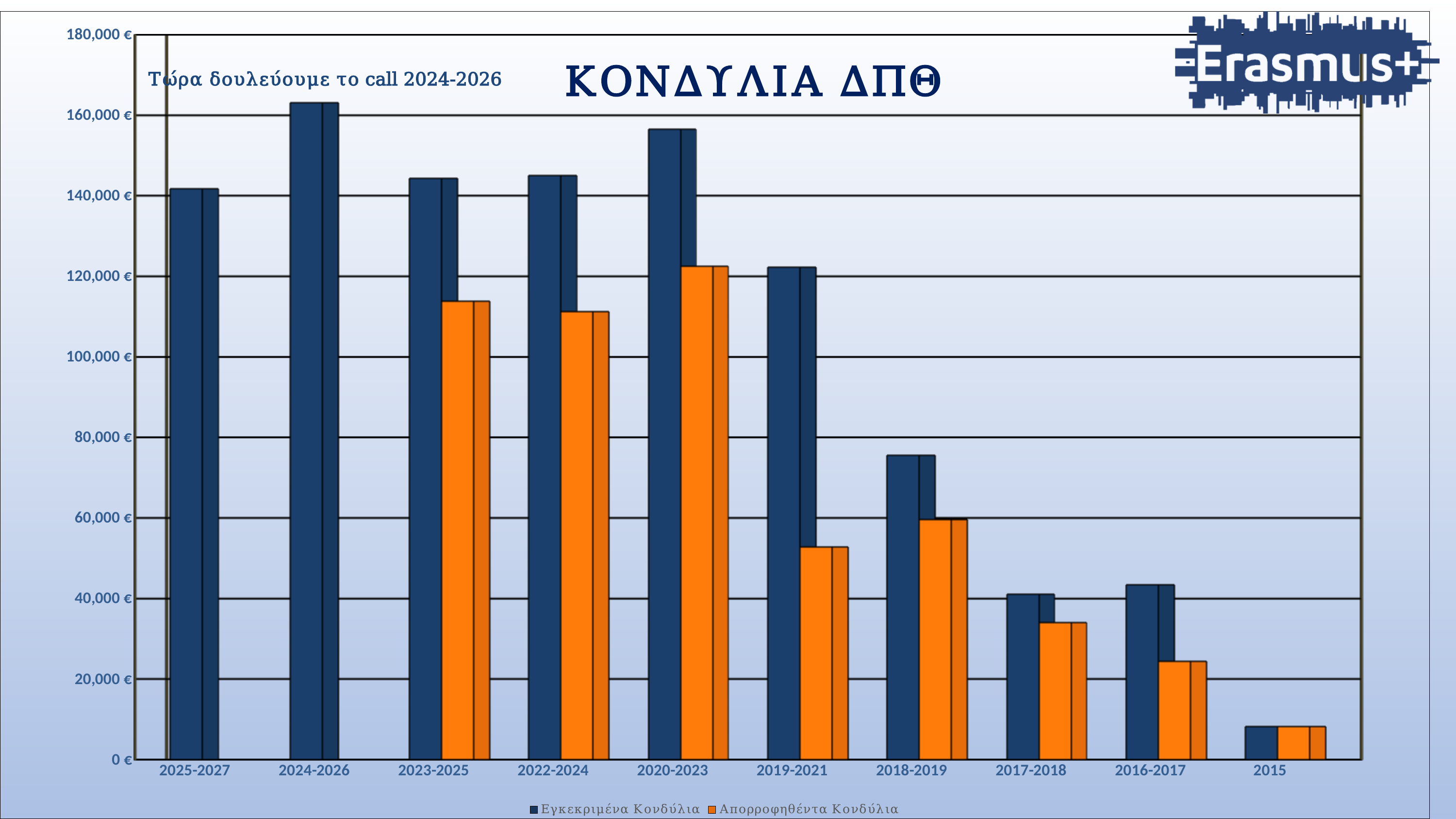
Is the Απορροφηθέντα Κονδύλια value for 2017-2018 greater or less than 40,000 €? less Which category has the highest value for Εγκεκριμένα Κονδύλια? 2024-2026 Is the Εγκεκριμένα Κονδύλια value for 2024-2026 greater or less than 160,000 €? greater Which category has the lowest value for Εγκεκριμένα Κονδύλια? 2015 Which is larger: the Απορροφηθέντα Κονδύλια value for 2020-2023 or for 2023-2025? 2020-2023 How many categories are shown on the x axis? 10 Do the Εγκεκριμένα Κονδύλια values rise or fall from 2020-2023 to 2015 along the x axis? fall Is the Εγκεκριμένα Κονδύλια value for 2018-2019 greater or less than 80,000 €? less Which category has the highest value for Απορροφηθέντα Κονδύλια? 2020-2023 What is the title of the chart? ΚΟΝΔΥΛΙΑ ΔΠΘ What kind of chart is shown on the slide? bar chart How many series does the legend list? 2